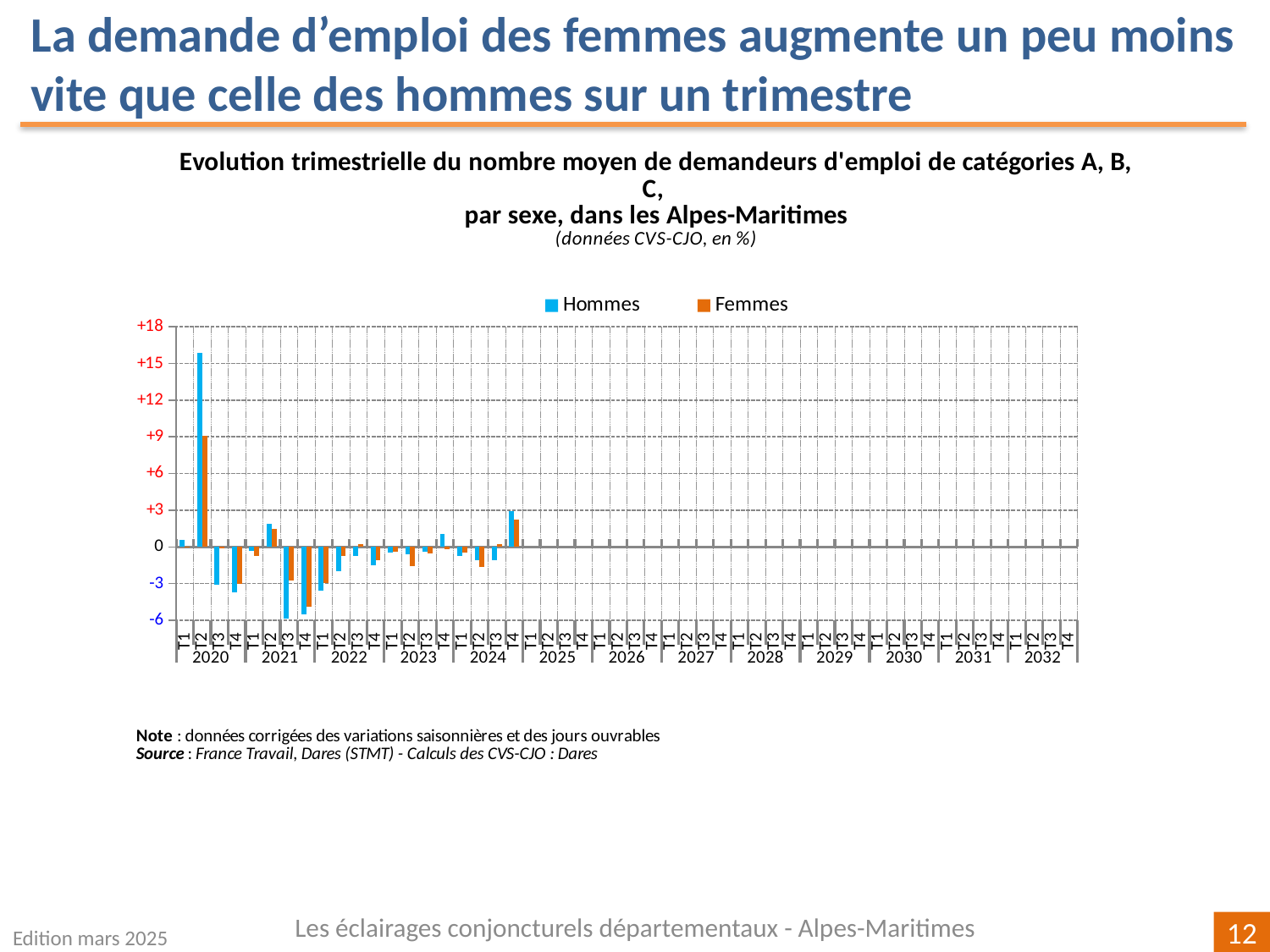
In which quarter does the Hommes series reach its highest value? T2 2020 What kind of chart is shown on the slide? bar chart In T4 2024, which series has the larger value, Hommes or Femmes? Hommes Is the Hommes value for T2 2020 greater or less than +12? greater In T2 2020, which series has the larger value, Hommes or Femmes? Hommes Is the Hommes value for T3 2021 greater or less than -3? less In which quarter does the Femmes series reach its highest value? T2 2020 Which series is shown in orange in the legend? Femmes How many years are labelled along the x axis? 13 How many series does the legend list? 2 Is the Femmes value for T2 2020 greater or less than +6? greater In which quarter does the Hommes series reach its lowest value? T3 2021